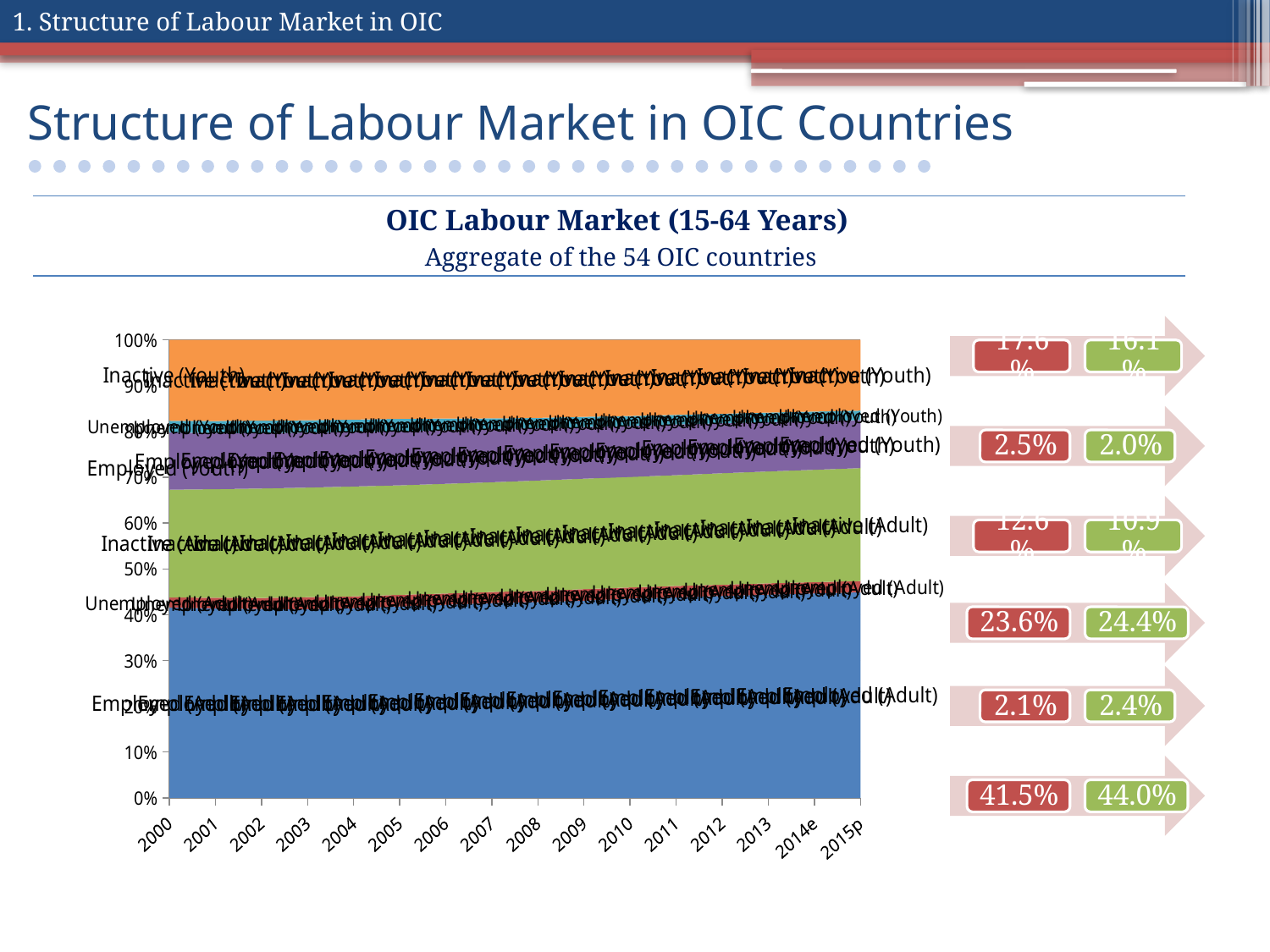
Is the Employed (Adult) share in 2015p greater or less than 30%? greater What value is shown in the green box of the bottom callout, next to the Employed (Adult) area? 44.0% What kind of chart is shown on the slide? Stacked area chart What value is shown in the green box of the callout next to the Unemployed (Youth) area? 2.0% How many years are shown along the x axis of the chart? 16 What value is shown in the red box of the bottom callout, next to the Employed (Adult) area? 41.5% What is the first year shown on the x axis? 2000 What value is shown in the red box of the top callout, next to the Inactive (Youth) area? 17.6% Which of the two values in the bottom callout (Employed (Adult)) is larger, the red box or the green box? green box (44.0%) How many series (labour market groups) are plotted in the chart? 6 What is the last category shown on the x axis? 2015p What is the title of the chart? OIC Labour Market (15-64 Years)